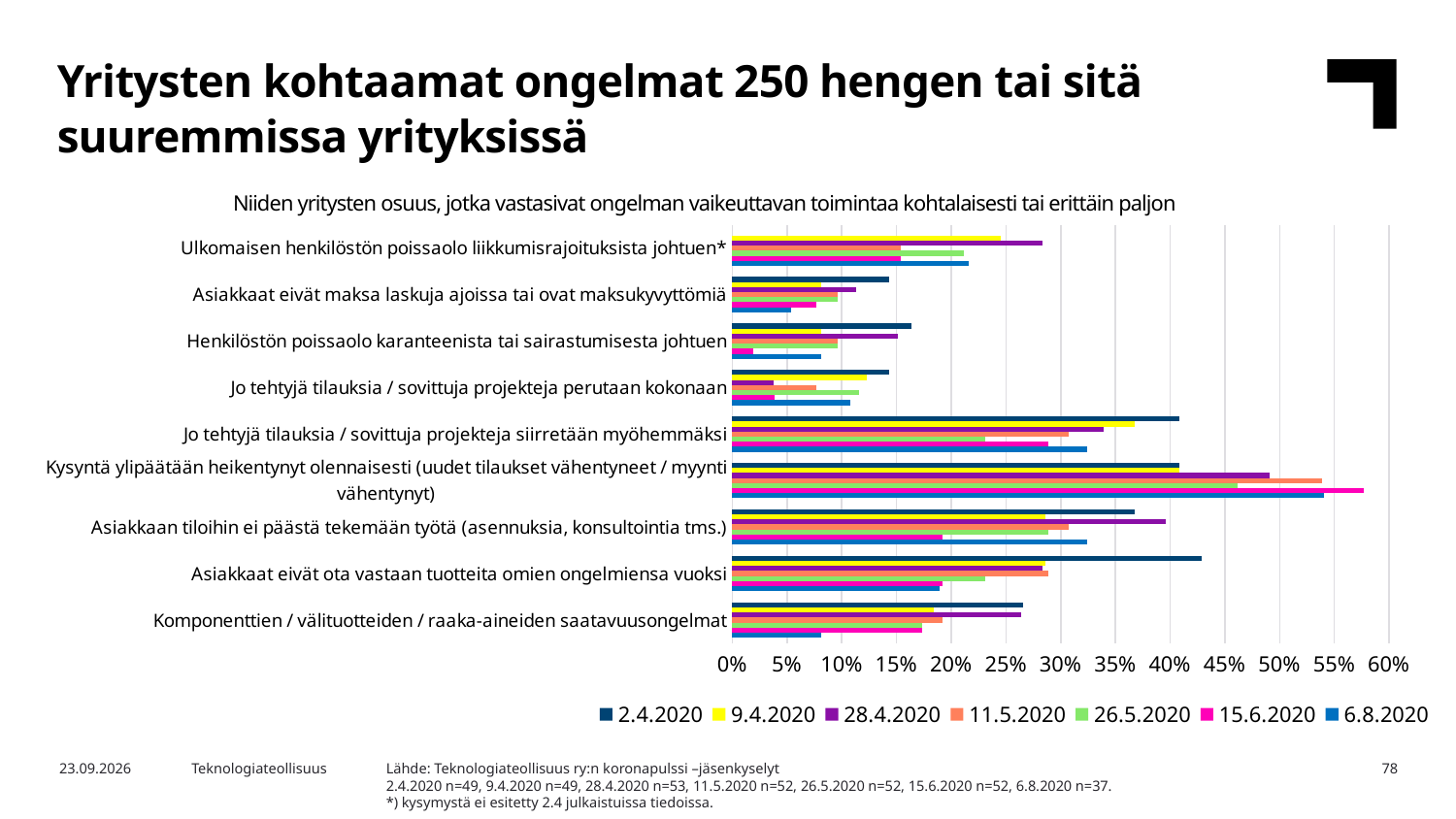
How many series (survey dates) does the legend list? 7 Is the 15.6.2020 value for 'Kysyntä ylipäätään heikentynyt olennaisesti' greater or less than 55%? greater Is the 6.8.2020 value for 'Henkilöstön poissaolo karanteenista tai sairastumisesta johtuen' greater or less than 10%? less What is the subtitle shown above the chart? Niiden yritysten osuus, jotka vastasivat ongelman vaikeuttavan toimintaa kohtalaisesti tai erittäin paljon For 'Kysyntä ylipäätään heikentynyt olennaisesti', which is larger: the 15.6.2020 value or the 6.8.2020 value? 15.6.2020 Is the 2.4.2020 value for 'Asiakkaat eivät ota vastaan tuotteita omien ongelmiensa vuoksi' greater or less than 40%? greater For the 2.4.2020 series, which is larger: 'Asiakkaat eivät ota vastaan tuotteita omien ongelmiensa vuoksi' or 'Asiakkaan tiloihin ei päästä tekemään työtä'? Asiakkaat eivät ota vastaan tuotteita omien ongelmiensa vuoksi What is the first series listed in the legend? 2.4.2020 Which category has the longest bar on the chart? Kysyntä ylipäätään heikentynyt olennaisesti (uudet tilaukset vähentyneet / myynti vähentynyt) What kind of chart is shown on the slide? Bar chart How many problem categories are listed on the chart? 9